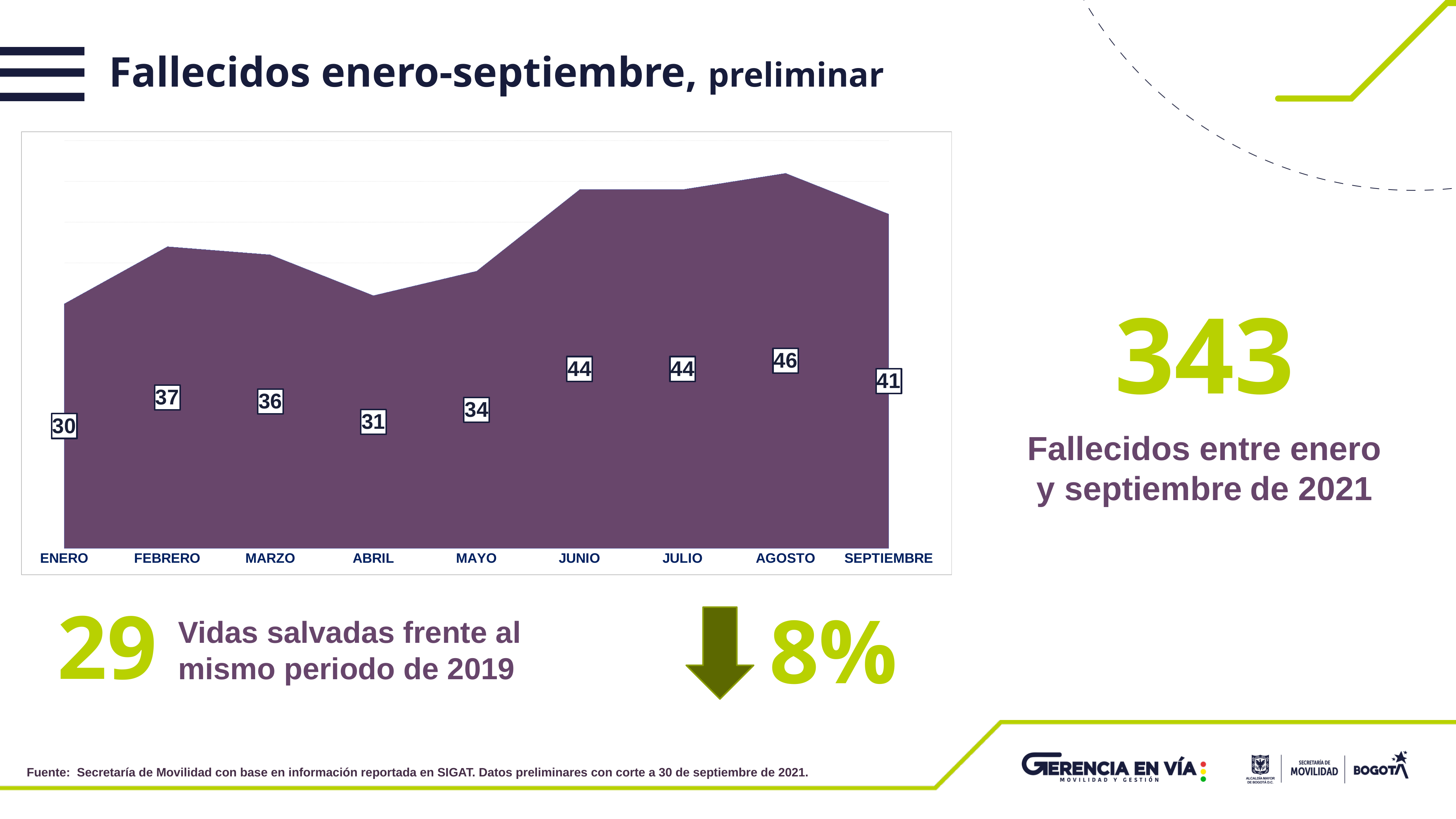
Which is larger, the value for FEBRERO or the value for ABRIL? FEBRERO Do the values rise or fall from ABRIL to AGOSTO? rise What is the difference between the values for JUNIO and MAYO? 10 Which month has the highest value? AGOSTO What is the value for ENERO? 30 What is the value for SEPTIEMBRE? 41 What is the value for AGOSTO? 46 How many months are plotted on the chart? 9 What kind of chart is shown on the slide? area chart Which month has the lowest value? ENERO What is the title of the slide containing the chart? Fallecidos enero-septiembre, preliminar What is the difference between the values for AGOSTO and ENERO? 16